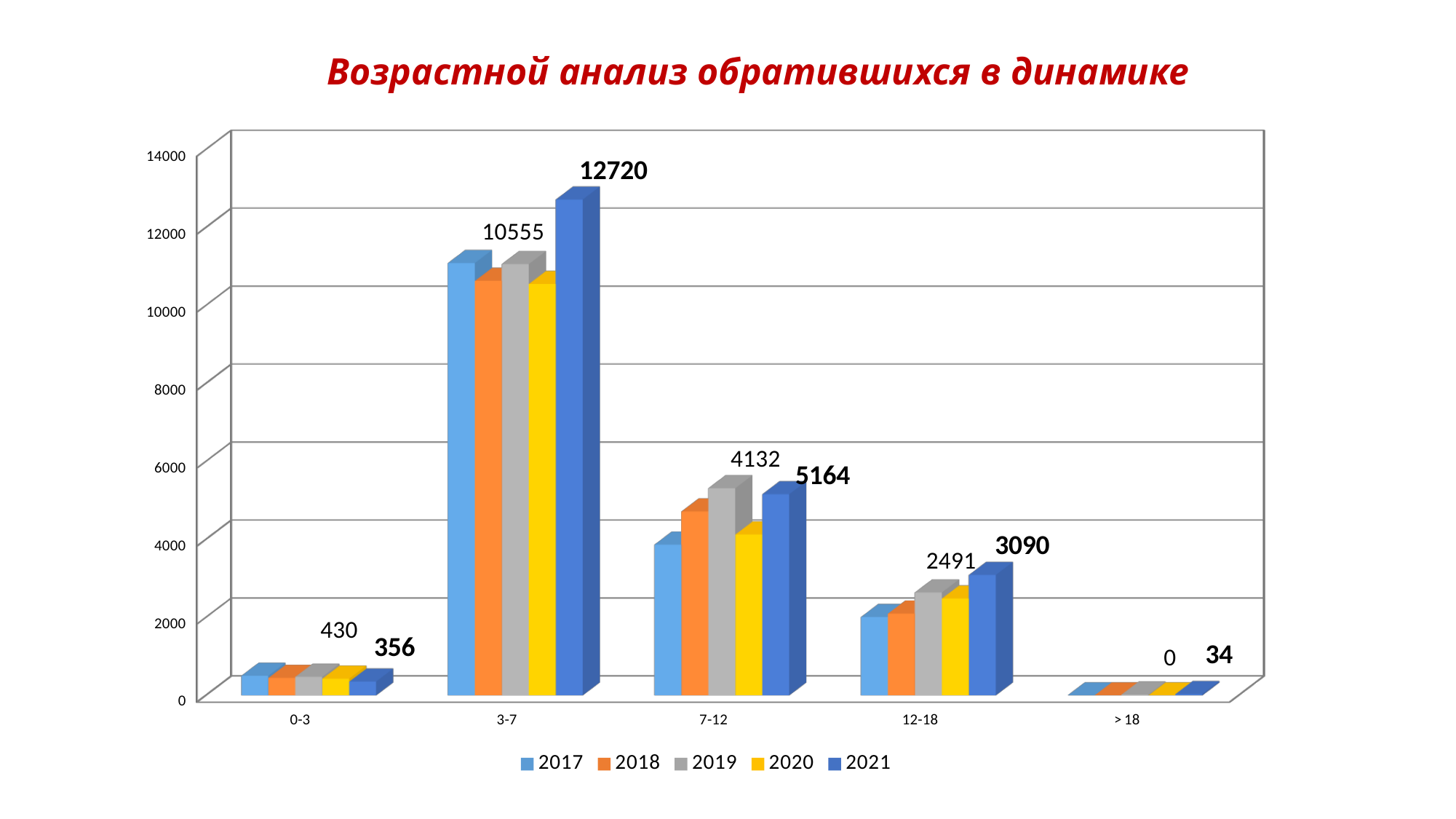
What is the value for the 12-18 age group in 2021? 3090 Which age group has the highest value in 2021? 3-7 Which age group has the lowest value in 2020? > 18 How many age groups are shown on the x axis? 5 What is the value for the > 18 age group in 2020? 0 Is the value for the 3-7 age group in 2017 greater or less than 10000? greater What is the value for the 7-12 age group in 2020? 4132 What is the difference between the 2021 and 2020 values for the 3-7 age group? 2165 What is the value for the 3-7 age group in 2021? 12720 For the 0-3 age group, which is larger: the 2020 value or the 2021 value? 2020 What is the difference between the 2021 and 2020 values for the 12-18 age group? 599 How many series does the legend list? 5